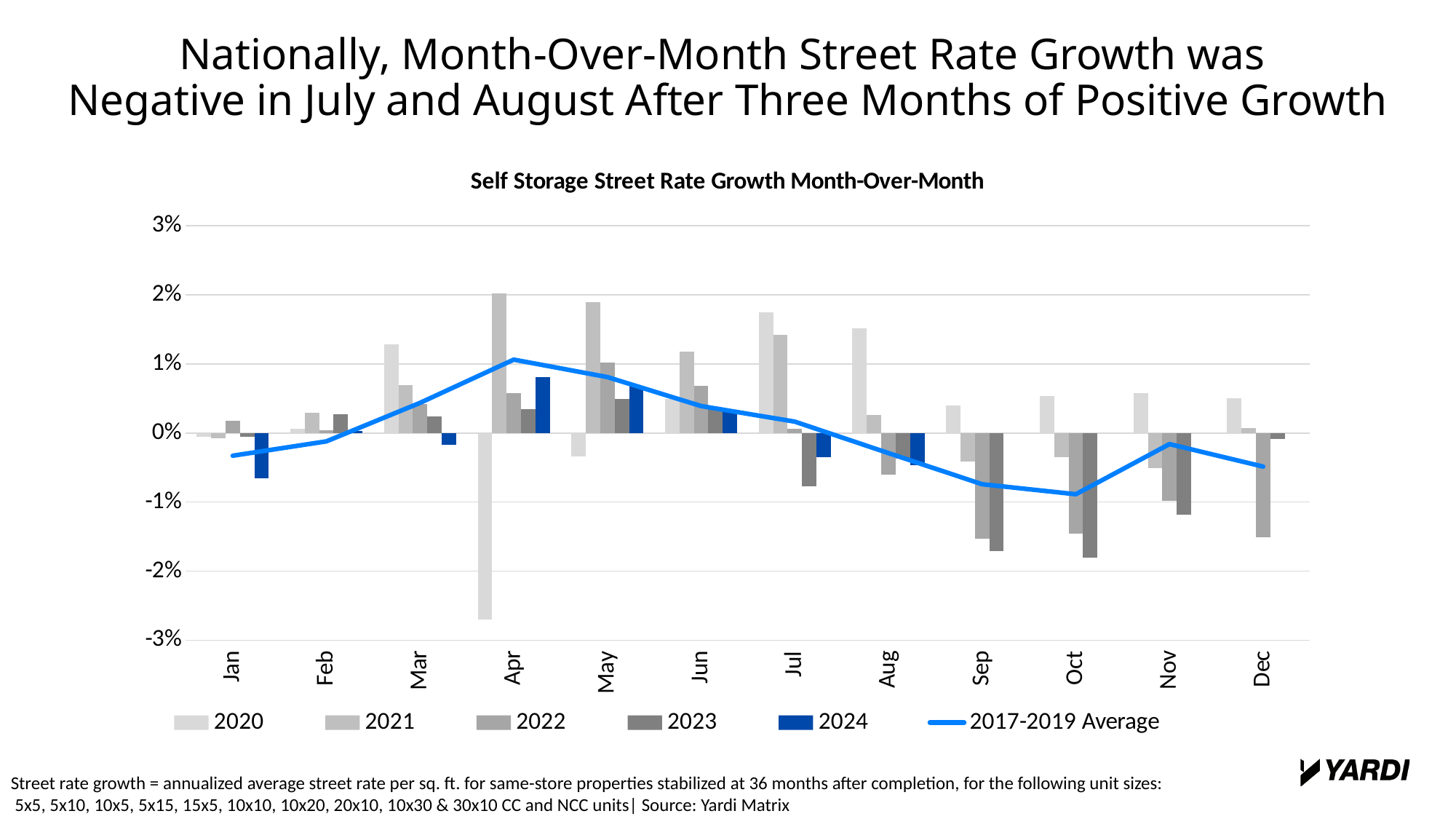
What is the title of the chart? Self Storage Street Rate Growth Month-Over-Month Which series is drawn as a line rather than bars? 2017-2019 Average Does the 2017-2019 Average line rise or fall from Jan to Apr? rise How many series does the legend list? 6 How many months are shown on the x axis? 12 Is the 2024 value for Apr greater or less than 1%? less Is the 2020 value for Apr greater or less than -2%? less Is the 2020 value for Jul greater or less than 1%? greater Which month has the highest 2024 bar? Apr What kind of chart is this? bar chart with a line series Which month has the lowest bar for 2020? Apr